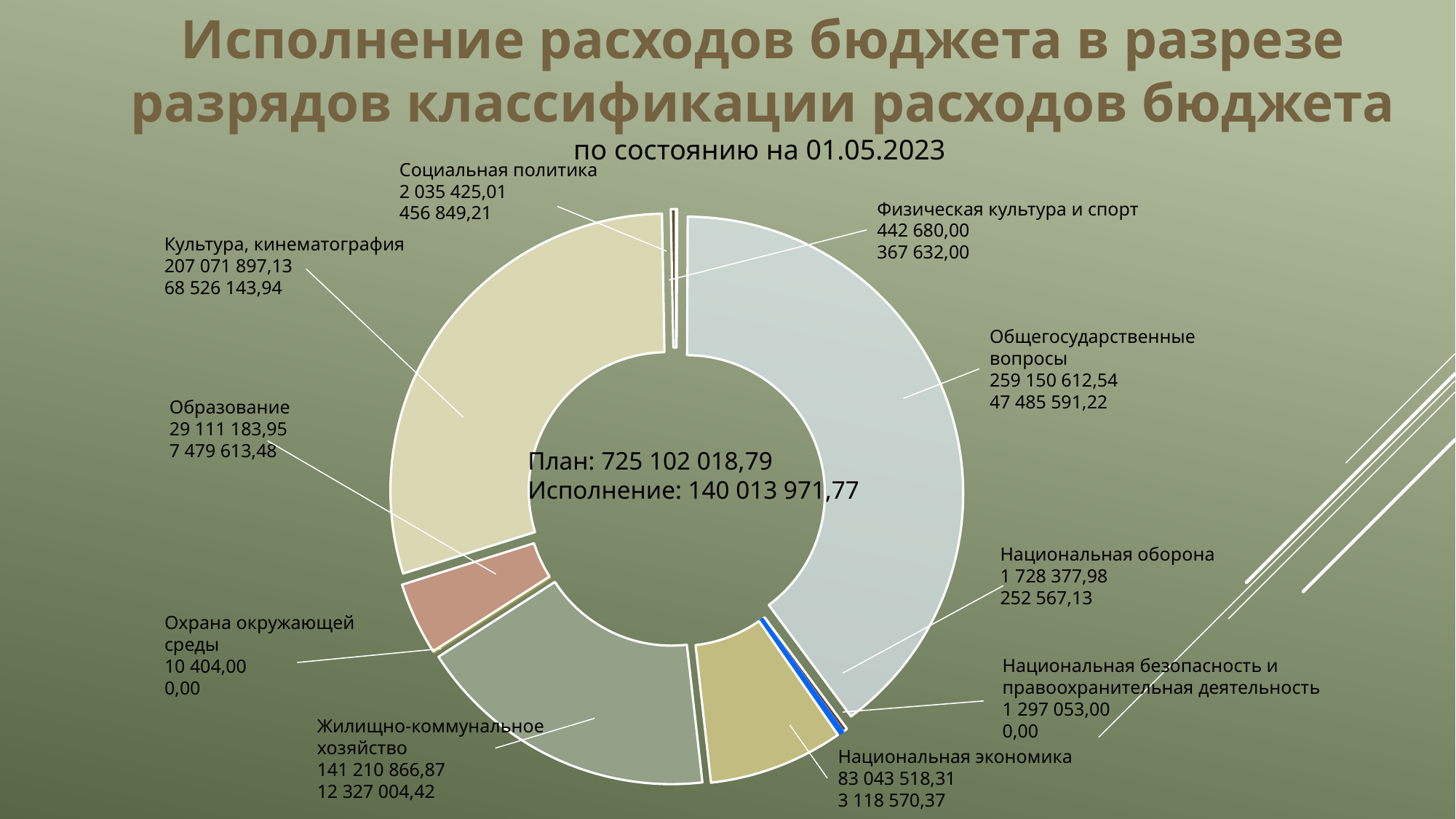
How many categories (slices) does the chart show? 10 What is the first (plan) value shown for Общегосударственные вопросы? 259 150 612,54 What kind of chart is shown on the slide? Doughnut (pie) chart What total execution value (Исполнение) is shown in the centre of the chart? 140 013 971,77 What is the first value shown for Национальная экономика? 83 043 518,31 Which has the larger first value: Образование or Национальная экономика? Национальная экономика What is the second (execution) value shown for Культура, кинематография? 68 526 143,94 Which category has the smallest first (plan) value? Охрана окружающей среды What is the first value shown for Жилищно-коммунальное хозяйство? 141 210 866,87 Which category has the largest first (plan) value? Общегосударственные вопросы What total plan value (План) is shown in the centre of the chart? 725 102 018,79 What is the second value shown for Охрана окружающей среды? 0,00